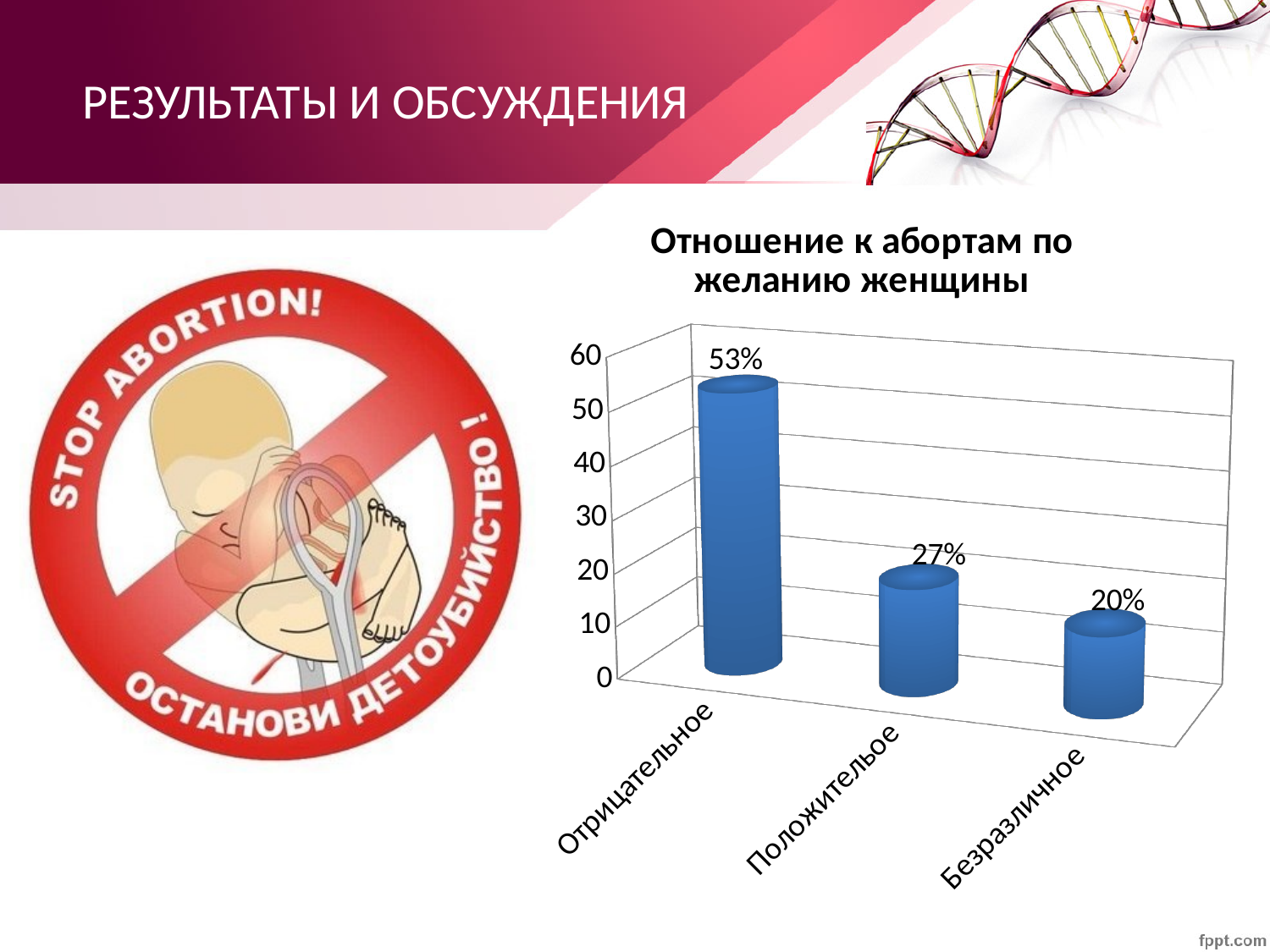
Which category has the highest value? Отрицательное What is the title of the chart? Отношение к абортам по желанию женщины What is the difference between the values for Положительое and Безразличное? 7% What is the value for Отрицательное? 53% What is the difference between the values for Отрицательное and Положительое? 26% How many categories are shown in the chart? 3 Is the value for Отрицательное greater or less than 50? greater What is the value for Положительое? 27% What kind of chart is shown on the slide? bar chart Which is larger, the value for Положительое or the value for Безразличное? Положительое What is the value for Безразличное? 20% Which category has the lowest value? Безразличное